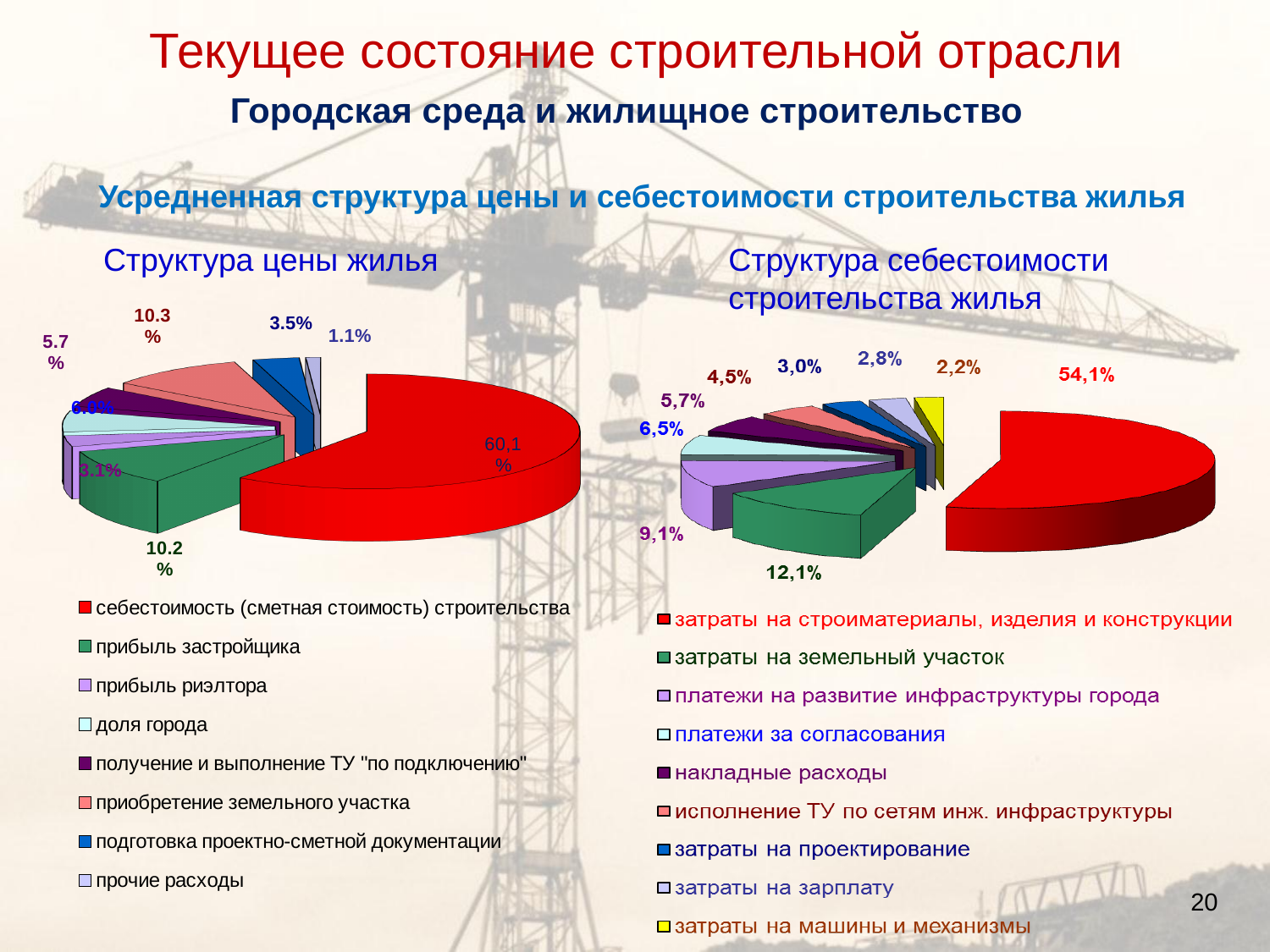
What kind of chart is 'Структура себестоимости строительства жилья'? pie chart In the chart 'Структура цены жилья', how many entries does the legend list? 8 In the chart 'Структура себестоимости строительства жилья', which is larger: 'платежи на развитие инфраструктуры города' or 'платежи за согласования'? платежи на развитие инфраструктуры города In the chart 'Структура себестоимости строительства жилья', how many entries does the legend list? 9 In the chart 'Структура цены жилья', what share is labelled for 'прибыль застройщика'? 10.2% In the chart 'Структура себестоимости строительства жилья', what share is labelled for 'затраты на строиматериалы, изделия и конструкции'? 54,1% In the chart 'Структура себестоимости строительства жилья', what share is labelled for 'затраты на машины и механизмы'? 2,2% In the chart 'Структура цены жилья', which category has the largest slice? себестоимость (сметная стоимость) строительства In the chart 'Структура цены жилья', which category has the smallest slice? прочие расходы In the chart 'Структура цены жилья', what share is labelled for 'себестоимость (сметная стоимость) строительства'? 60,1% In the chart 'Структура себестоимости строительства жилья', what share is labelled for 'затраты на земельный участок'? 12,1% In the chart 'Структура себестоимости строительства жилья', which category has the smallest slice? затраты на машины и механизмы